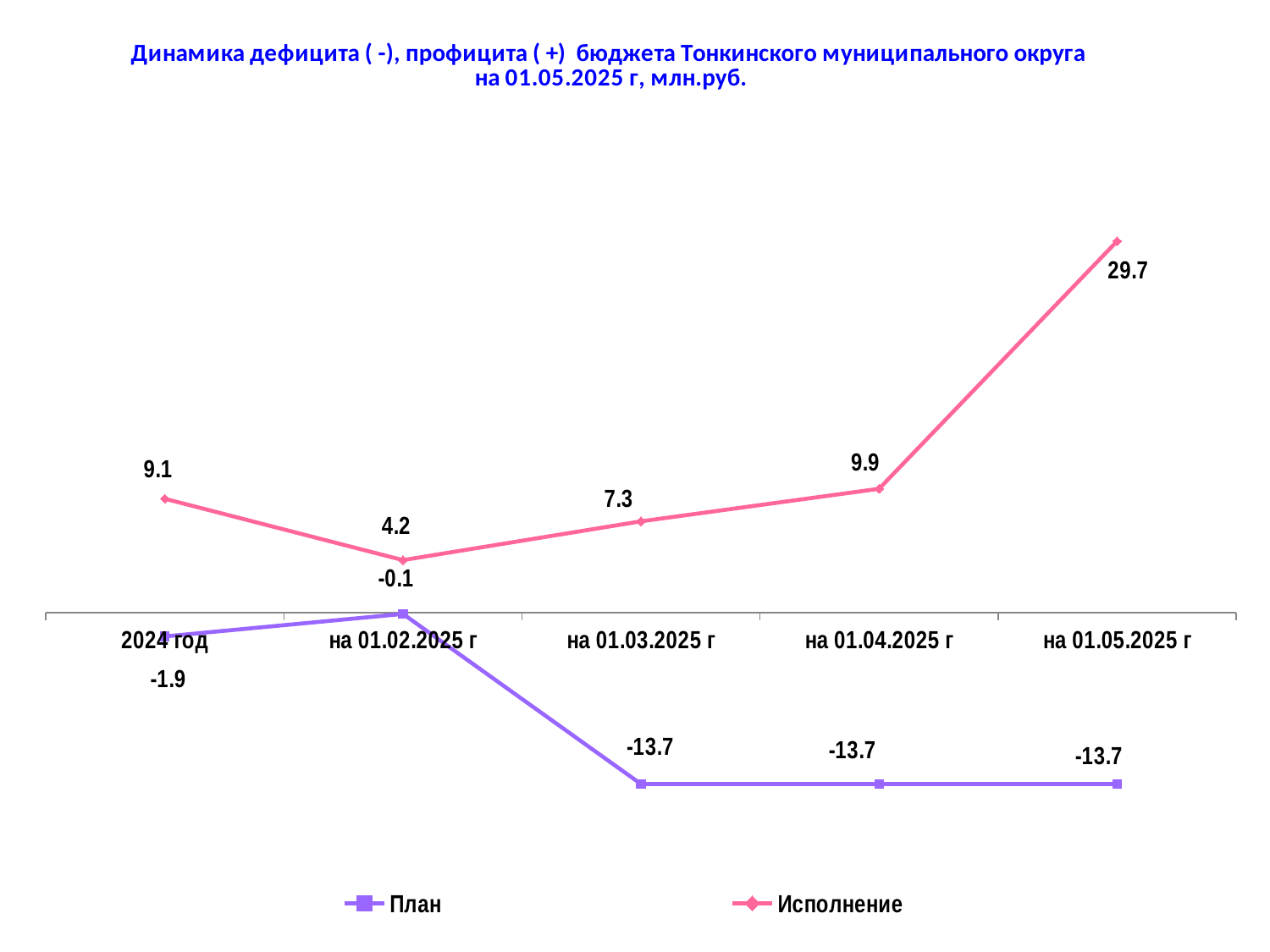
What is the value of План for на 01.02.2025 г? -0.1 How many series does the legend list? 2 For which category is Исполнение lowest? на 01.02.2025 г What kind of chart is shown on the slide? Line chart What is the value of План for 2024 год? -1.9 For which category is Исполнение highest? на 01.05.2025 г What is the value of Исполнение for на 01.05.2025 г? 29.7 How many categories are shown along the x axis? 5 Which is larger for 2024 год: План or Исполнение? Исполнение Does Исполнение rise or fall from на 01.02.2025 г to на 01.05.2025 г? Rise What is the difference between Исполнение and План for на 01.04.2025 г? 23.6 What is the value of Исполнение for на 01.03.2025 г? 7.3